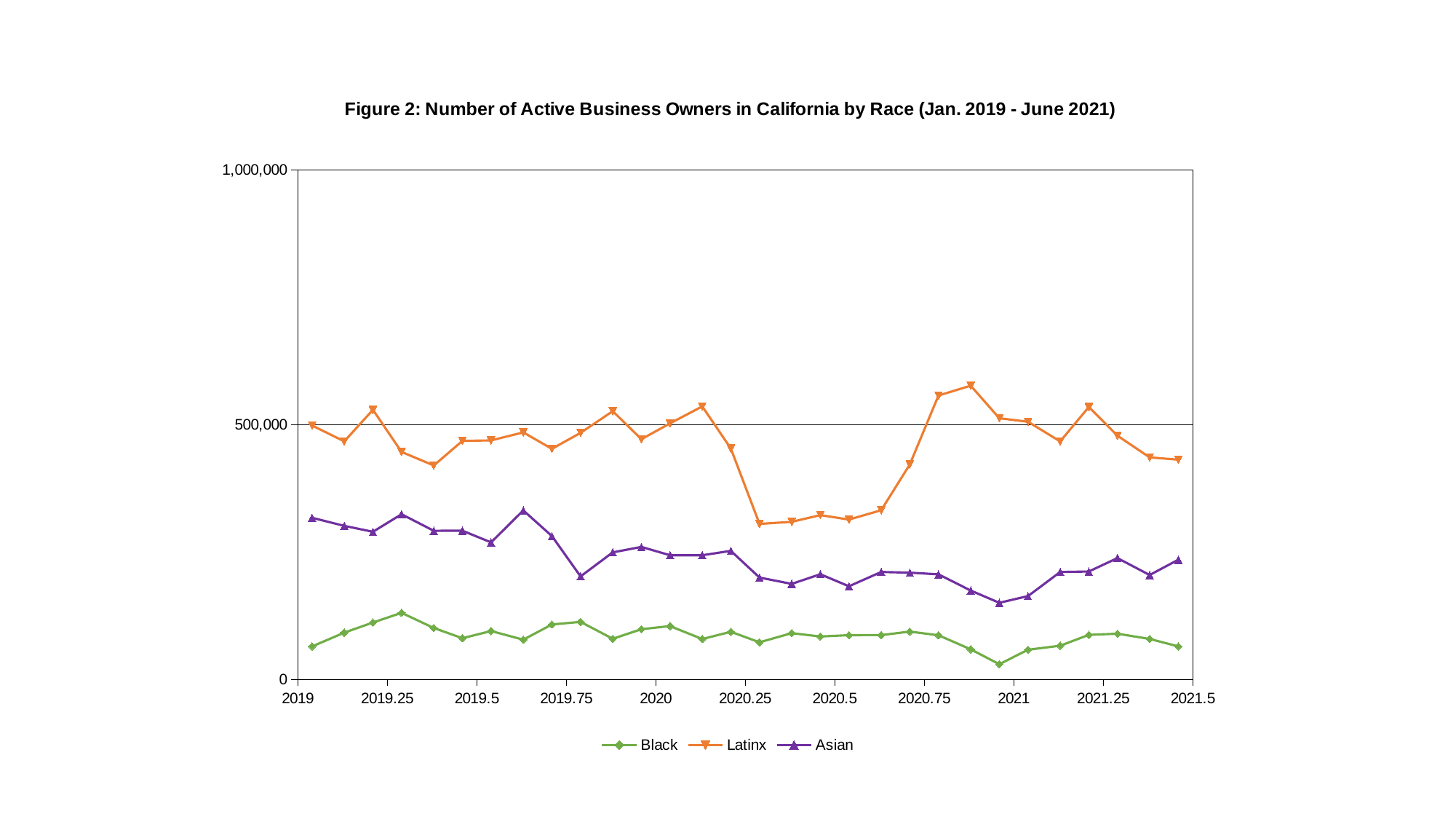
What is the title of the chart? Figure 2: Number of Active Business Owners in California by Race (Jan. 2019 - June 2021) Does the Latinx series rise or fall between 2020 and 2020.25? fall Does the Latinx series rise or fall between 2020.25 and 2020.75? rise Which series has the lowest values throughout the chart? Black What kind of chart is shown on the slide? Line chart Is the value for Latinx at around 2020.25 greater or less than 500,000? less How many series does the legend list? 3 Which series has the highest values throughout the chart? Latinx Which series is plotted in orange? Latinx Is the value for Asian at 2019 greater or less than 500,000? less At 2020, which is larger, the value for Asian or the value for Black? Asian